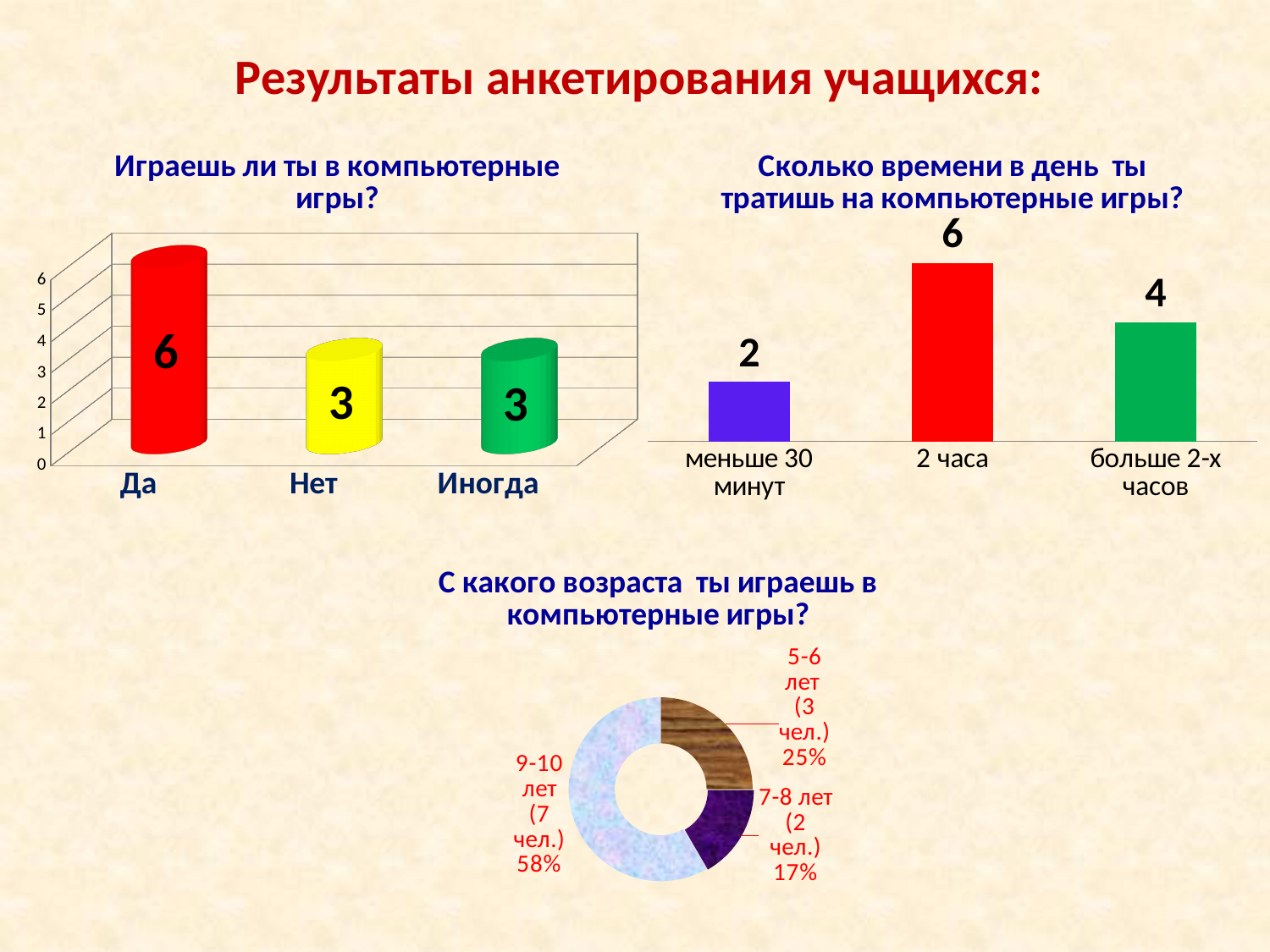
In the chart titled "С какого возраста ты играешь в компьютерные игры?", how many people are in the "7-8 лет" group? 2 чел. In the chart titled "Играешь ли ты в компьютерные игры?", which category has the highest value? Да In the chart titled "Сколько времени в день ты тратишь на компьютерные игры?", what is the difference between the values for "больше 2-х часов" and "меньше 30 минут"? 2 What kind of chart is the one titled "С какого возраста ты играешь в компьютерные игры?"? Doughnut chart In the chart titled "Сколько времени в день ты тратишь на компьютерные игры?", what is the value for "2 часа"? 6 In the chart titled "Играешь ли ты в компьютерные игры?", what is the difference between the values for "Да" and "Нет"? 3 In the chart titled "С какого возраста ты играешь в компьютерные игры?", what share does "9-10 лет" have? 58% In the chart titled "Играешь ли ты в компьютерные игры?", what is the value for "Да"? 6 In the chart titled "Сколько времени в день ты тратишь на компьютерные игры?", which is larger: the value for "2 часа" or for "больше 2-х часов"? 2 часа In the chart titled "Играешь ли ты в компьютерные игры?", what colour is the bar for "Нет"? Yellow In the chart titled "Играешь ли ты в компьютерные игры?", how many categories are shown? 3 In the chart titled "Сколько времени в день ты тратишь на компьютерные игры?", which category has the lowest value? меньше 30 минут